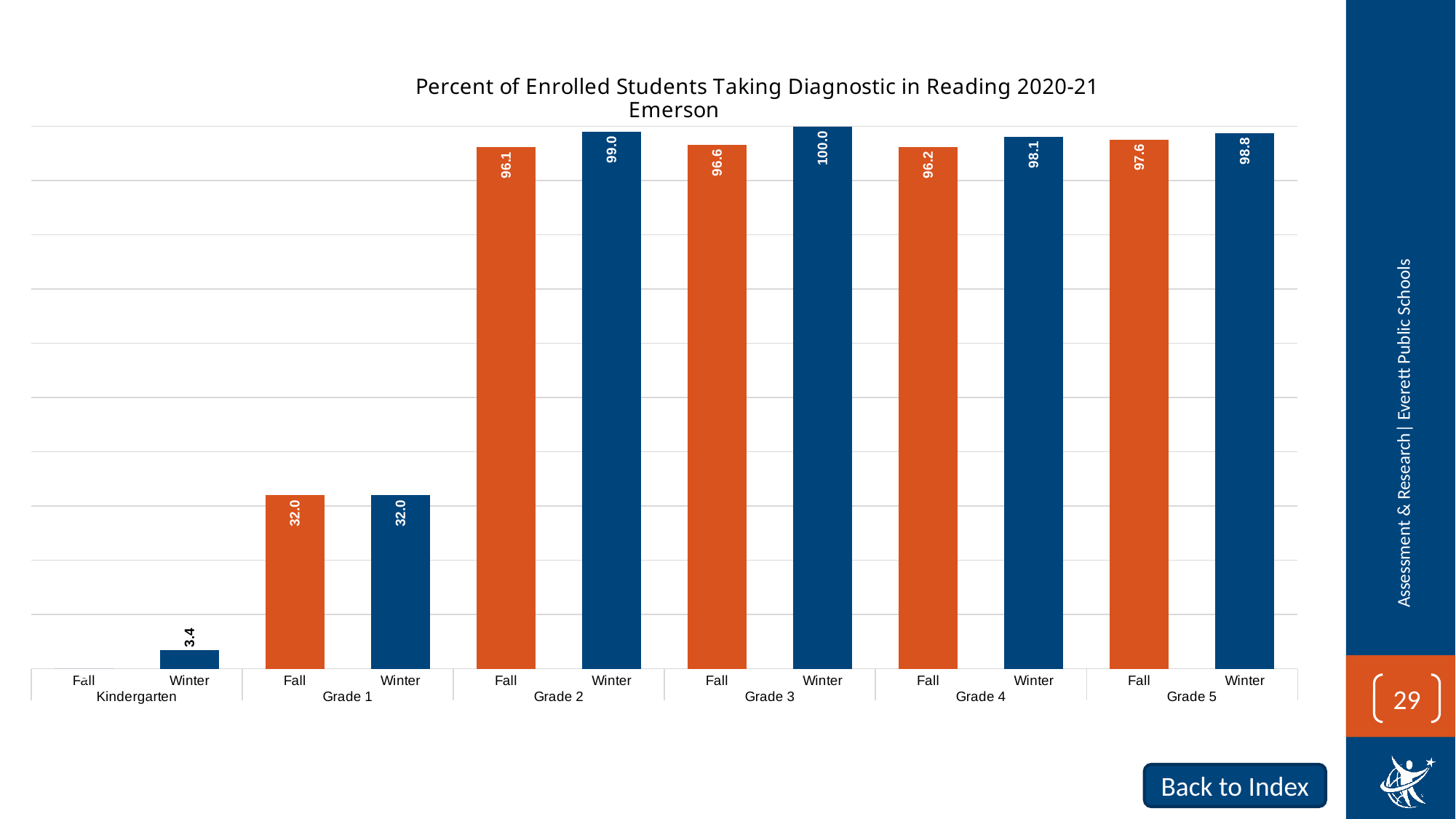
Which is larger for Grade 5, the Fall value or the Winter value? Winter How many grade levels are shown on the x axis? 6 What is the difference between the Winter and Fall values for Grade 4? 1.9 What is the Winter value for Kindergarten? 3.4 What is the Winter value for Grade 3? 100.0 Which grade has the lowest Winter value? Kindergarten Which bar has the highest value on the chart? Grade 3 Winter What is the Fall value for Grade 2? 96.1 What kind of chart is shown on the slide? Bar chart What is the Fall value for Grade 5? 97.6 Are the Fall and Winter values for Grade 1 the same or different? The same (32.0) What is the difference between the Winter and Fall values for Grade 2? 2.9